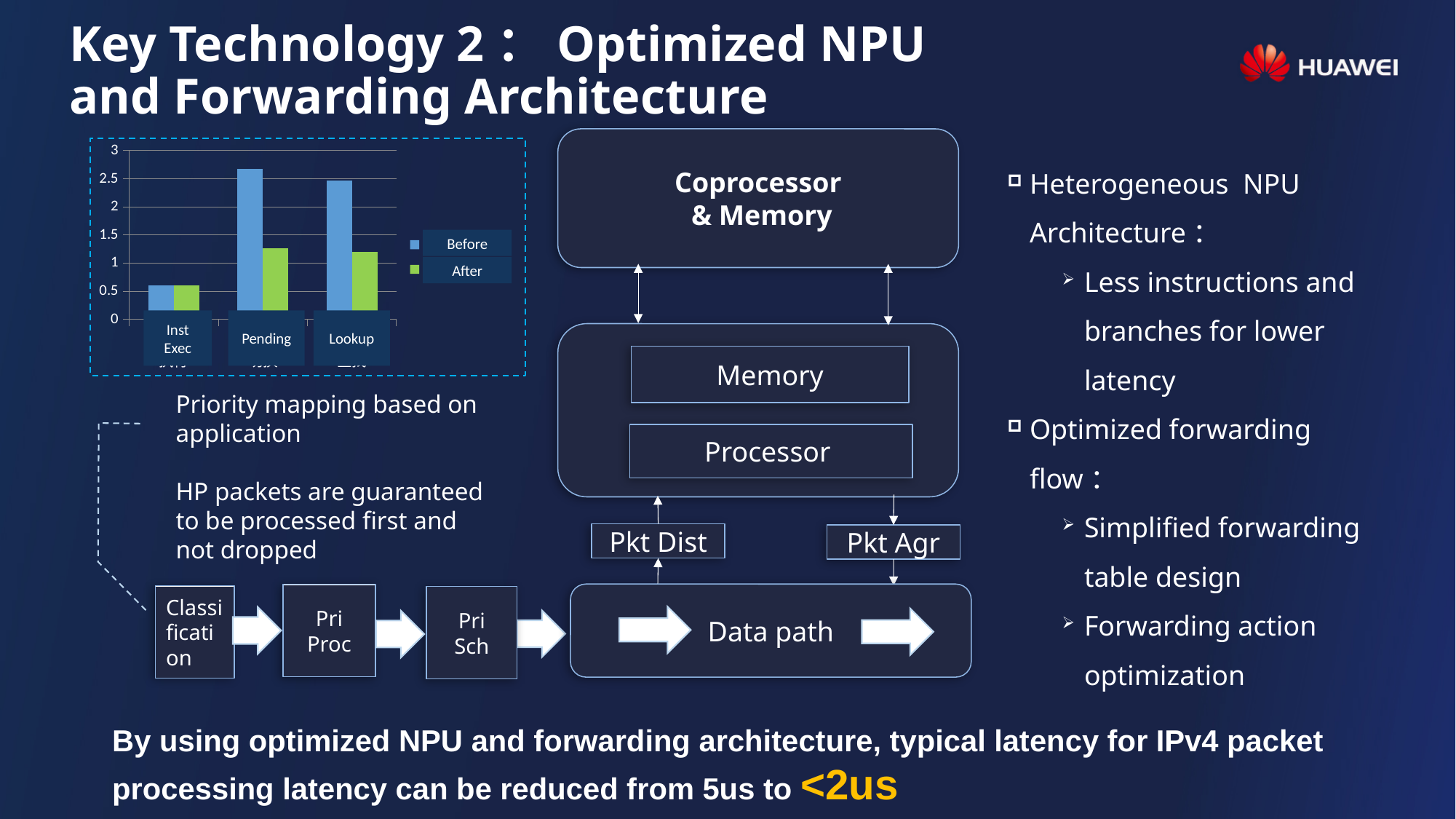
What are the two series named in the legend of the bar chart? Before and After How many series does the legend of the bar chart list? 2 Is the After value for Pending greater or less than 1? greater Is the After value for Lookup greater or less than 1.5? less Is the Before value for Inst Exec greater or less than 1? less Which category has the lowest Before value in the bar chart? Inst Exec How many categories are shown on the x axis of the bar chart? 3 For Pending, which is larger, the Before value or the After value? Before What kind of chart is shown on the left of the slide? bar chart Which colour represents the Before series in the bar chart? blue